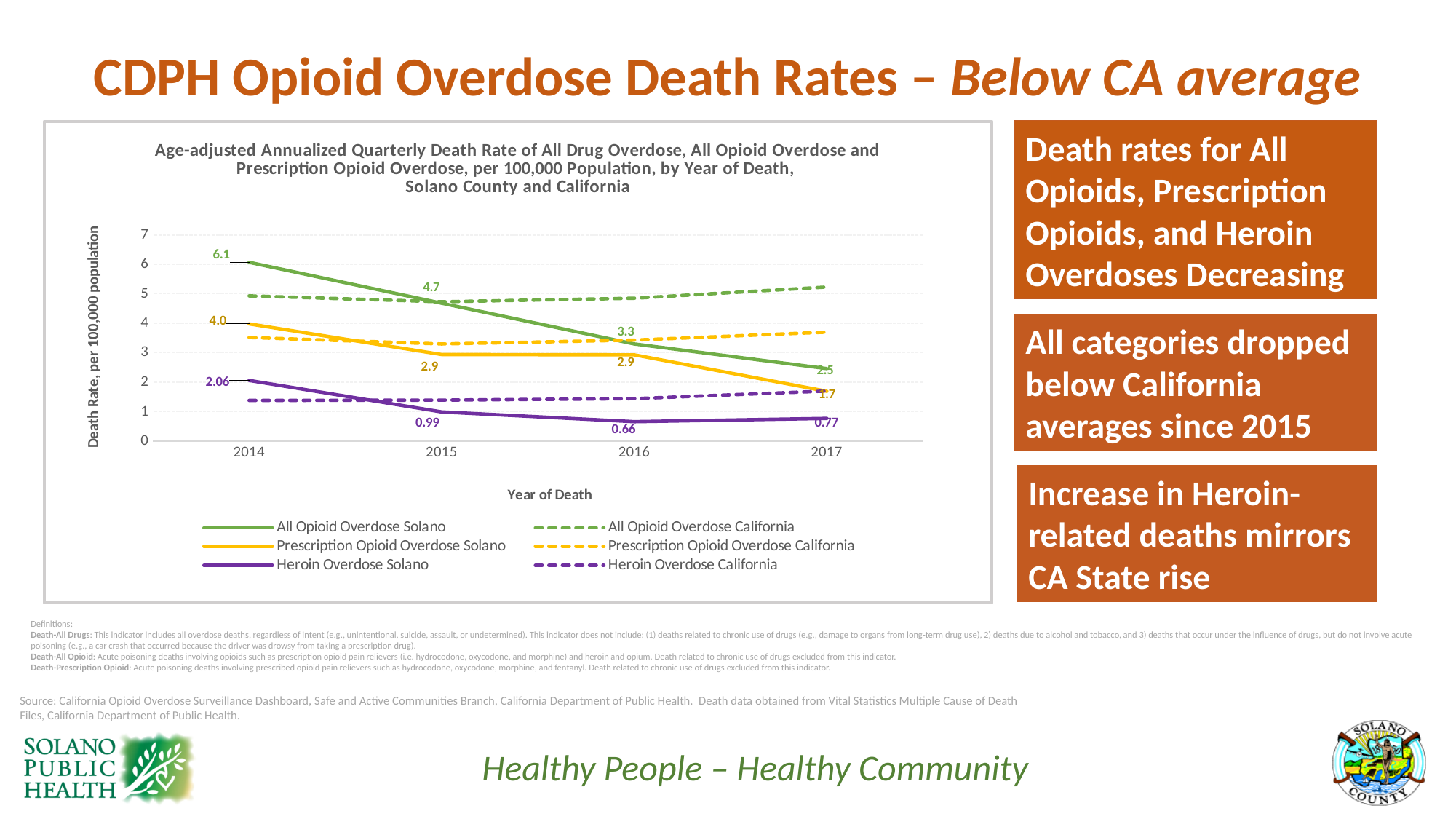
What is the value for All Opioid Overdose Solano in 2014? 6.1 How many years are shown on the x axis? 4 By how much did the All Opioid Overdose Solano rate fall from 2014 to 2017? 3.6 In which year was the All Opioid Overdose Solano rate highest? 2014 In which year was the Heroin Overdose Solano rate lowest? 2016 What is the value for Prescription Opioid Overdose Solano in 2017? 1.7 What kind of chart is shown on the slide? Line chart In 2017, which is larger: All Opioid Overdose Solano or Prescription Opioid Overdose Solano? All Opioid Overdose Solano How many series does the legend list? 6 What is the value for Heroin Overdose Solano in 2016? 0.66 Is the value for Heroin Overdose California in 2014 greater or less than 2? less Is the value for All Opioid Overdose California in 2017 greater or less than 4? greater